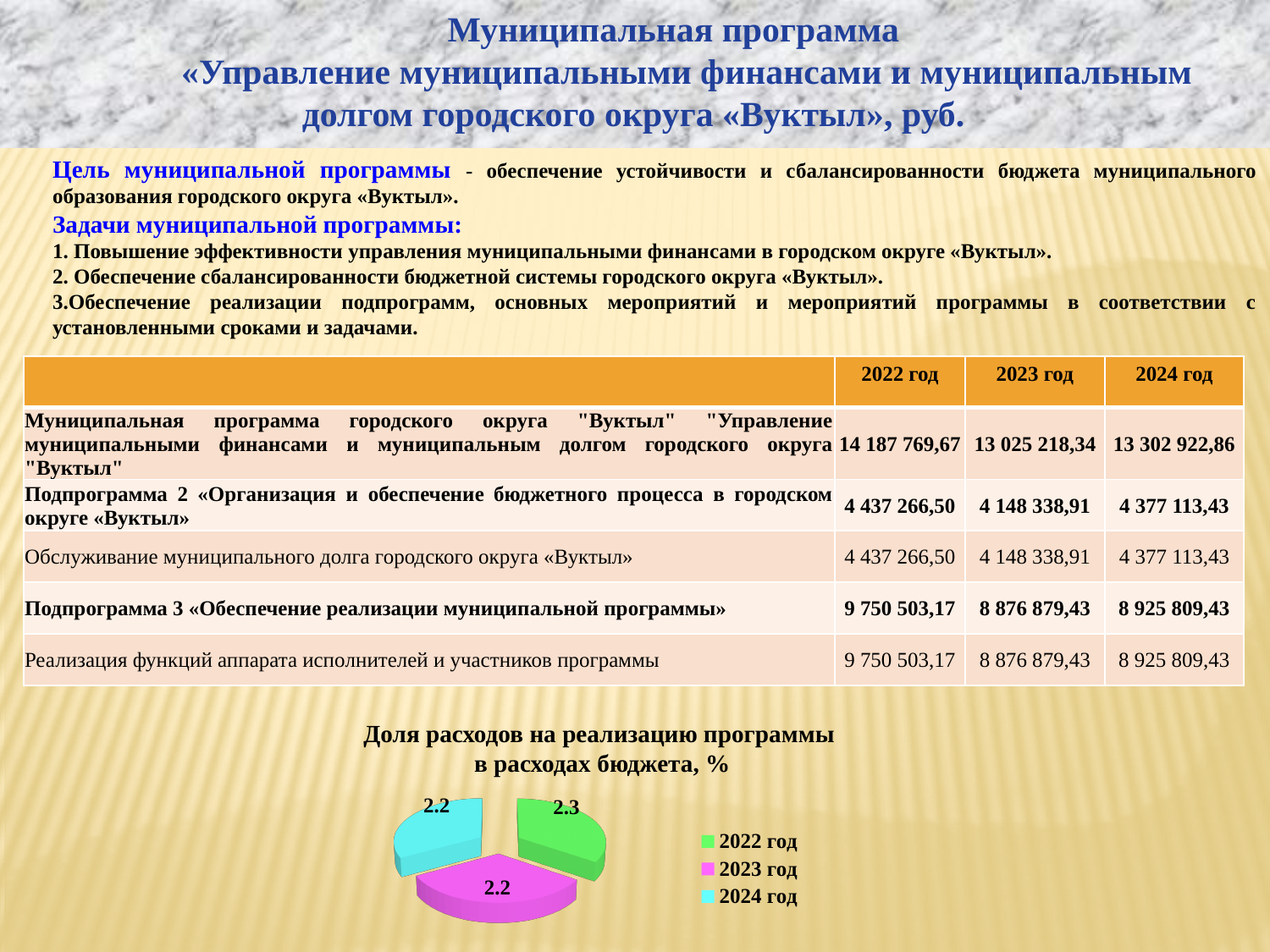
Which is larger in the pie chart, the value for 2022 год or the value for 2024 год? 2022 год Which year is represented by the green slice in the pie chart? 2022 год What is the title of the pie chart? Доля расходов на реализацию программы в расходах бюджета, % What is the value shown for 2022 год in the pie chart? 2.3 What is the value shown for 2024 год in the pie chart? 2.2 How many slices does the pie chart have? 3 How many entries does the legend of the pie chart list? 3 What type of chart is shown on the slide? Pie chart Which year has the highest value in the pie chart? 2022 год What is the difference between the values for 2022 год and 2023 год in the pie chart? 0.1 What is the value shown for 2023 год in the pie chart? 2.2